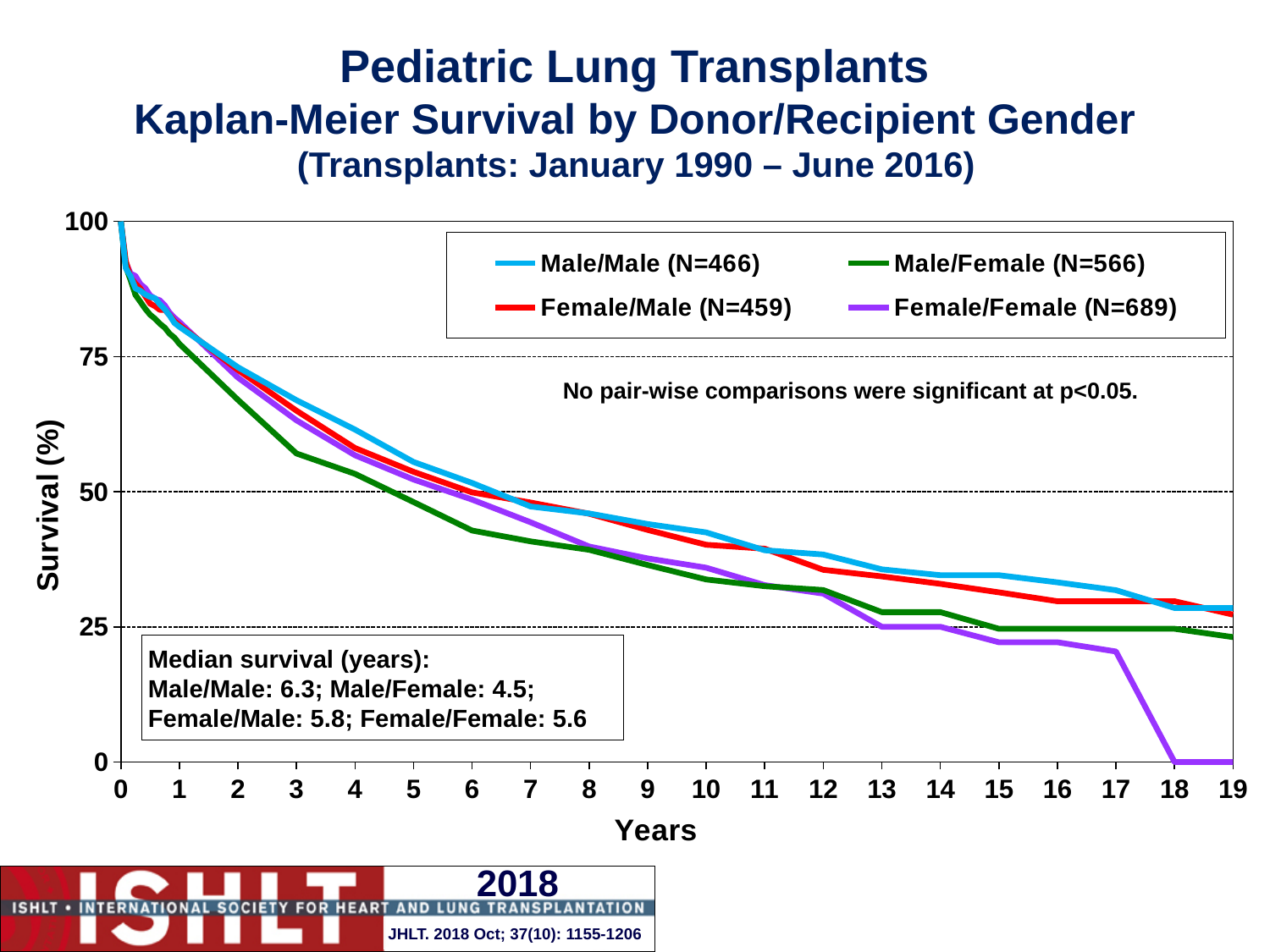
Is the survival for the Male/Male group at 10 years greater or less than 50? less What is the N for the Female/Female group shown in the legend? 689 What is the median survival in years for the Female/Female group? 5.6 At 3 years, which group has higher survival, Male/Male or Male/Female? Male/Male What is the median survival in years for the Male/Female group? 4.5 What kind of chart is shown on the slide? Line chart Is the survival for the Male/Female group at 3 years greater or less than 50? greater What is the difference in median survival (years) between the Male/Male and Male/Female groups? 1.8 Which donor/recipient gender group has the lowest median survival? Male/Female Which donor/recipient gender group has the highest median survival? Male/Male What is the median survival in years for the Male/Male group? 6.3 How many series does the legend list? 4